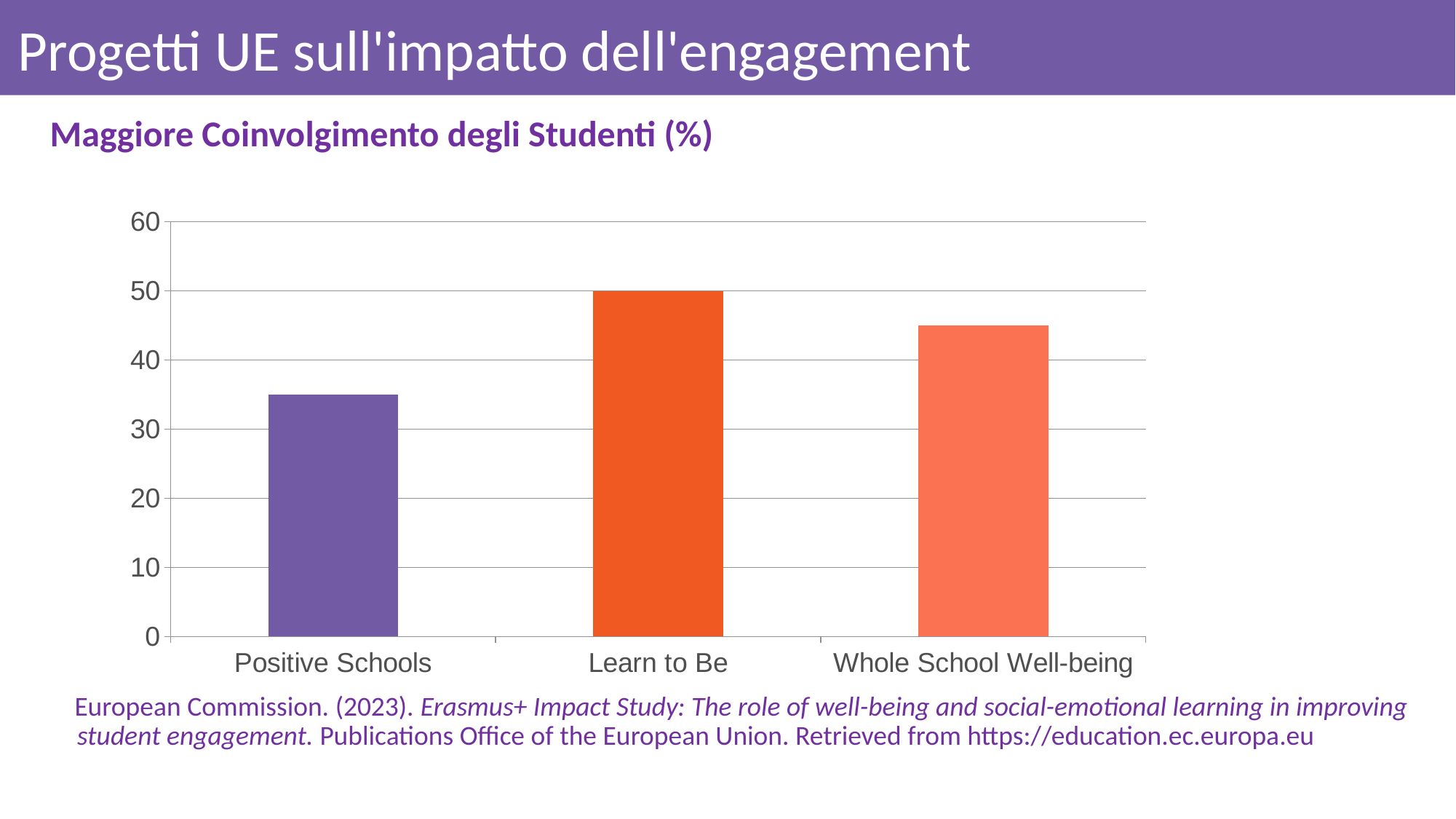
What is the highest value shown on the vertical axis? 60 Which is larger, the value for Positive Schools or the value for Whole School Well-being? Whole School Well-being What type of chart is shown on the slide? Bar chart Is the value for Positive Schools greater or less than 30? greater Is the value for Positive Schools greater or less than 40? less Which is larger, the value for Learn to Be or the value for Whole School Well-being? Learn to Be What is the value for Learn to Be? 50 Is the value for Whole School Well-being greater or less than 40? greater How many projects (categories) are shown in the chart? 3 What is the title of the chart? Maggiore Coinvolgimento degli Studenti (%) Which project has the highest value? Learn to Be Which project has the lowest value? Positive Schools